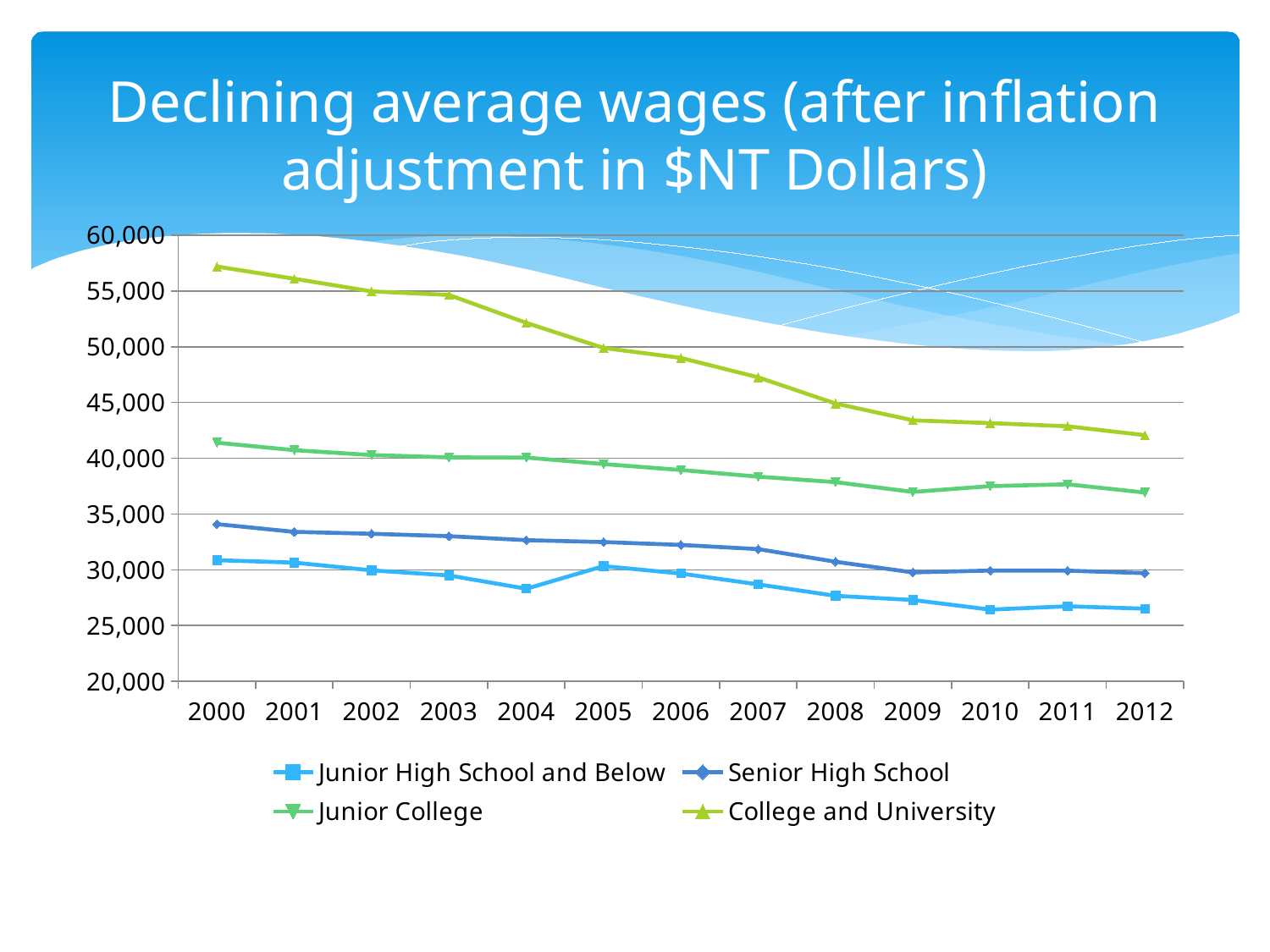
Which series has the highest value in 2000? College and University Is the value for College and University in 2012 greater or less than 45,000? less How many series does the legend list? 4 Which series has the lowest value in 2012? Junior High School and Below What kind of chart is shown on the slide? line chart Is the value for Junior High School and Below in 2010 greater or less than 30,000? less How many years are plotted along the x axis? 13 Is the value for College and University in 2000 greater or less than 55,000? greater What is the title of the chart? Declining average wages (after inflation adjustment in $NT Dollars) In 2005, which is larger: the value for Senior High School or the value for Junior College? Junior College Do the values for College and University rise or fall from 2000 to 2012? fall